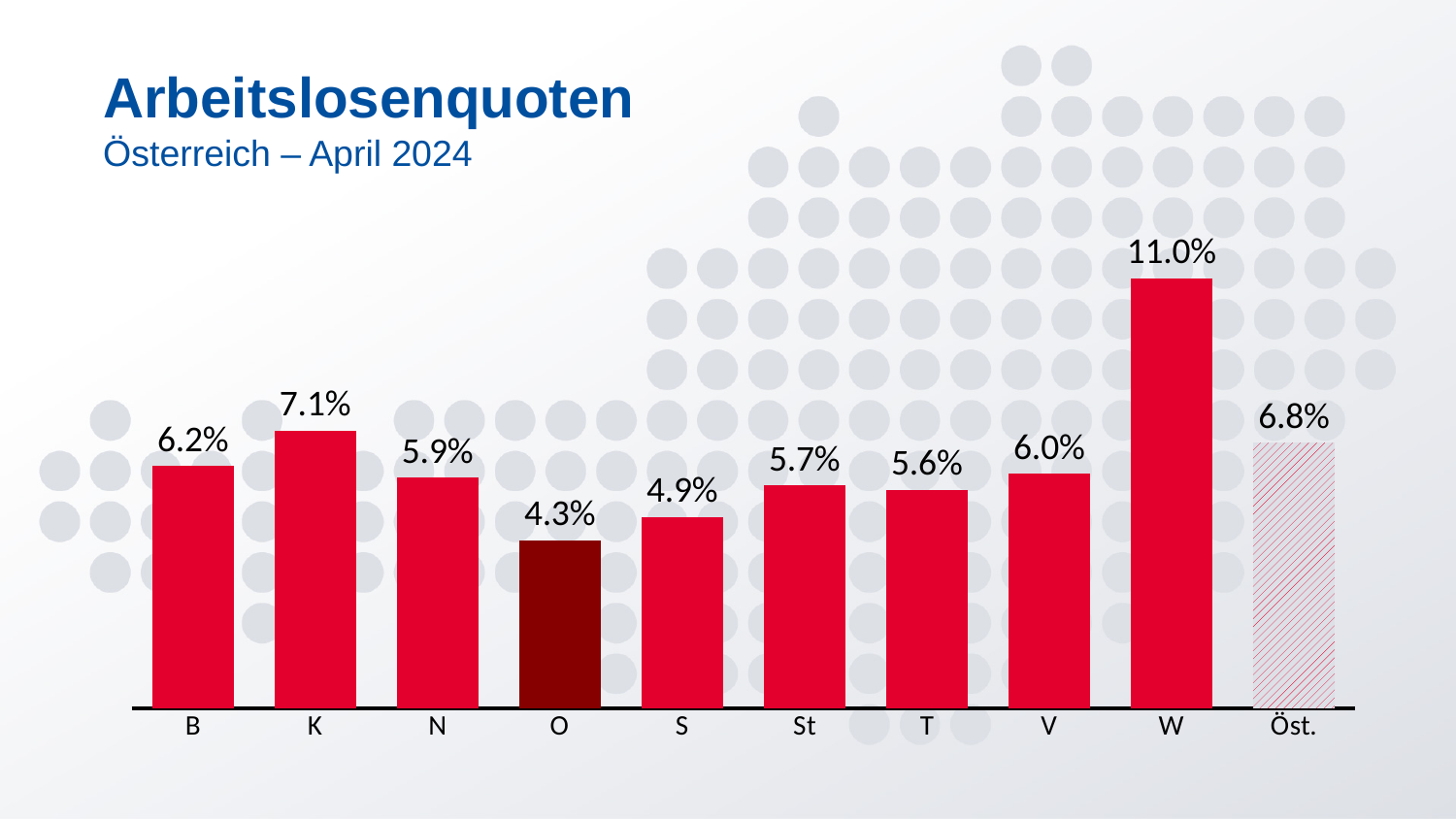
What kind of chart is shown on the slide? Bar chart What is the title of the chart on the slide? Arbeitslosenquoten Which has a higher value, V or T? V What is the difference between the values for K and B? 0.9% How many categories are shown on the x axis? 10 What is the value shown for Öst.? 6.8% What is the unemployment rate shown for W? 11.0% Which category has the highest value? W What is the value shown for O? 4.3% Which category has the lowest value? O What is the value shown for St? 5.7% What is the difference between the values for W and O? 6.7%